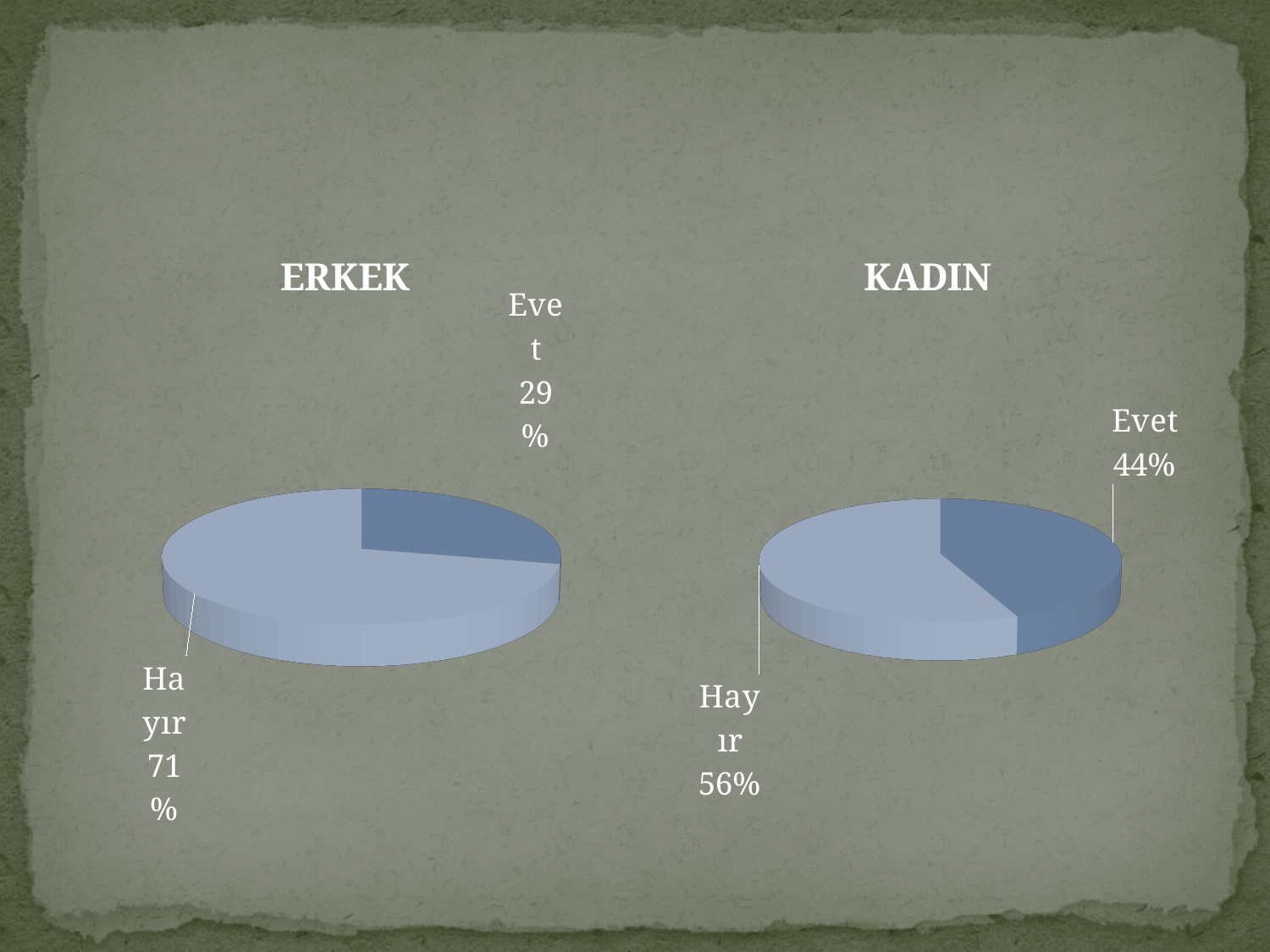
What is the title of the chart on the right side of the slide? KADIN How many slices does the KADIN chart have? 2 Which chart has the larger Evet share, ERKEK or KADIN? KADIN In the KADIN chart, what is the difference between the Hayır and Evet shares? 12% In the KADIN chart, what share of the pie is Evet? 44% In the ERKEK chart, what share of the pie is Evet? 29% What kind of chart is the ERKEK chart? Pie chart In the ERKEK chart, what share of the pie is Hayır? 71% In the ERKEK chart, what is the difference between the Hayır and Evet shares? 42% In the KADIN chart, which slice is the smallest? Evet In the ERKEK chart, which slice is the largest? Hayır